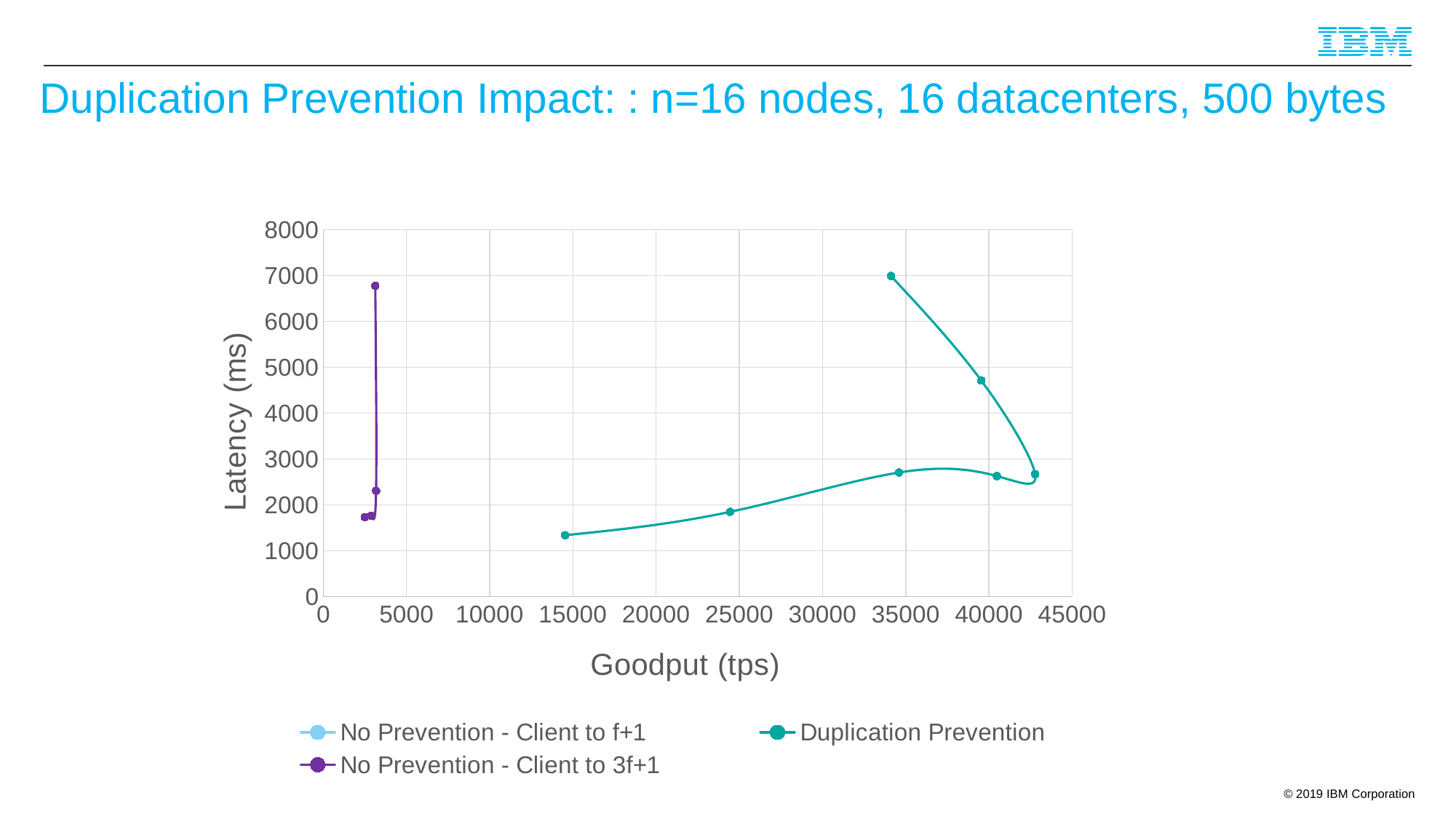
Which series reaches a higher goodput, Duplication Prevention or No Prevention - Client to 3f+1? Duplication Prevention What is the label of the y axis? Latency (ms) Is the highest latency of the No Prevention - Client to 3f+1 series greater or less than 6000 ms? greater Which series has the lowest latency point on the chart? Duplication Prevention Is the lowest latency of the Duplication Prevention series greater or less than 2000 ms? less Is the highest latency reached by the Duplication Prevention series greater or less than 6000 ms? greater How many series does the legend list? 3 What is the label of the x axis? Goodput (tps) What kind of chart is shown on the slide? line chart